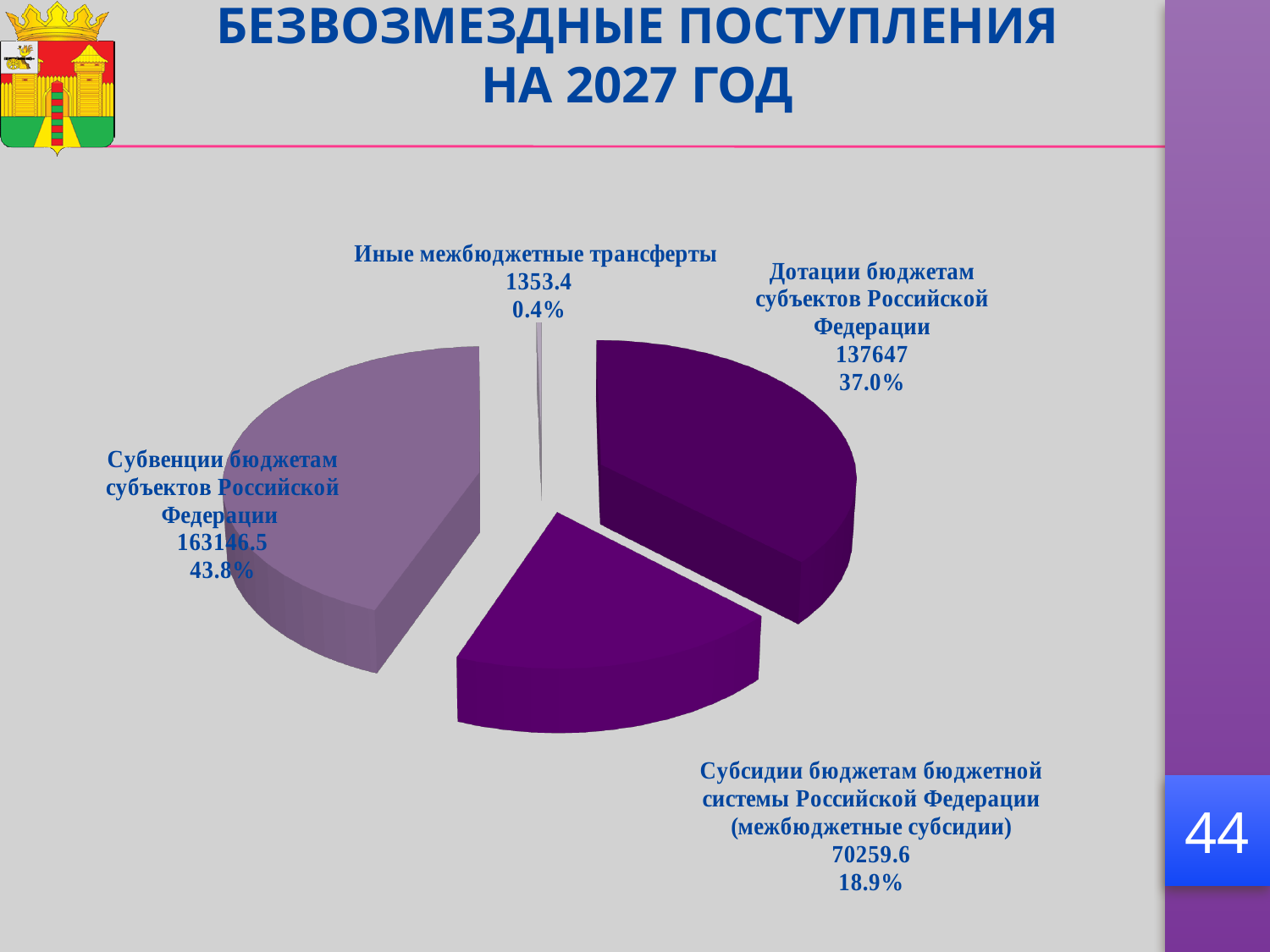
What share of the pie does Дотации бюджетам субъектов Российской Федерации represent? 37.0% How many slices does the pie chart have? 4 Which category has the largest slice of the pie? Субвенции бюджетам субъектов Российской Федерации What is the value for Иные межбюджетные трансферты? 1353.4 What kind of chart is shown on the slide? pie chart What is the value for Субвенции бюджетам субъектов Российской Федерации? 163146.5 What is the difference between the values for Субвенции бюджетам субъектов Российской Федерации and Дотации бюджетам субъектов Российской Федерации? 25499.5 What share of the pie does Субсидии бюджетам бюджетной системы Российской Федерации (межбюджетные субсидии) represent? 18.9% Which category has the smallest slice of the pie? Иные межбюджетные трансферты Which is larger: the value for Дотации бюджетам субъектов Российской Федерации or the value for Субсидии бюджетам бюджетной системы Российской Федерации (межбюджетные субсидии)? Дотации бюджетам субъектов Российской Федерации What is the value for Субсидии бюджетам бюджетной системы Российской Федерации (межбюджетные субсидии)? 70259.6 What is the value for Дотации бюджетам субъектов Российской Федерации? 137647